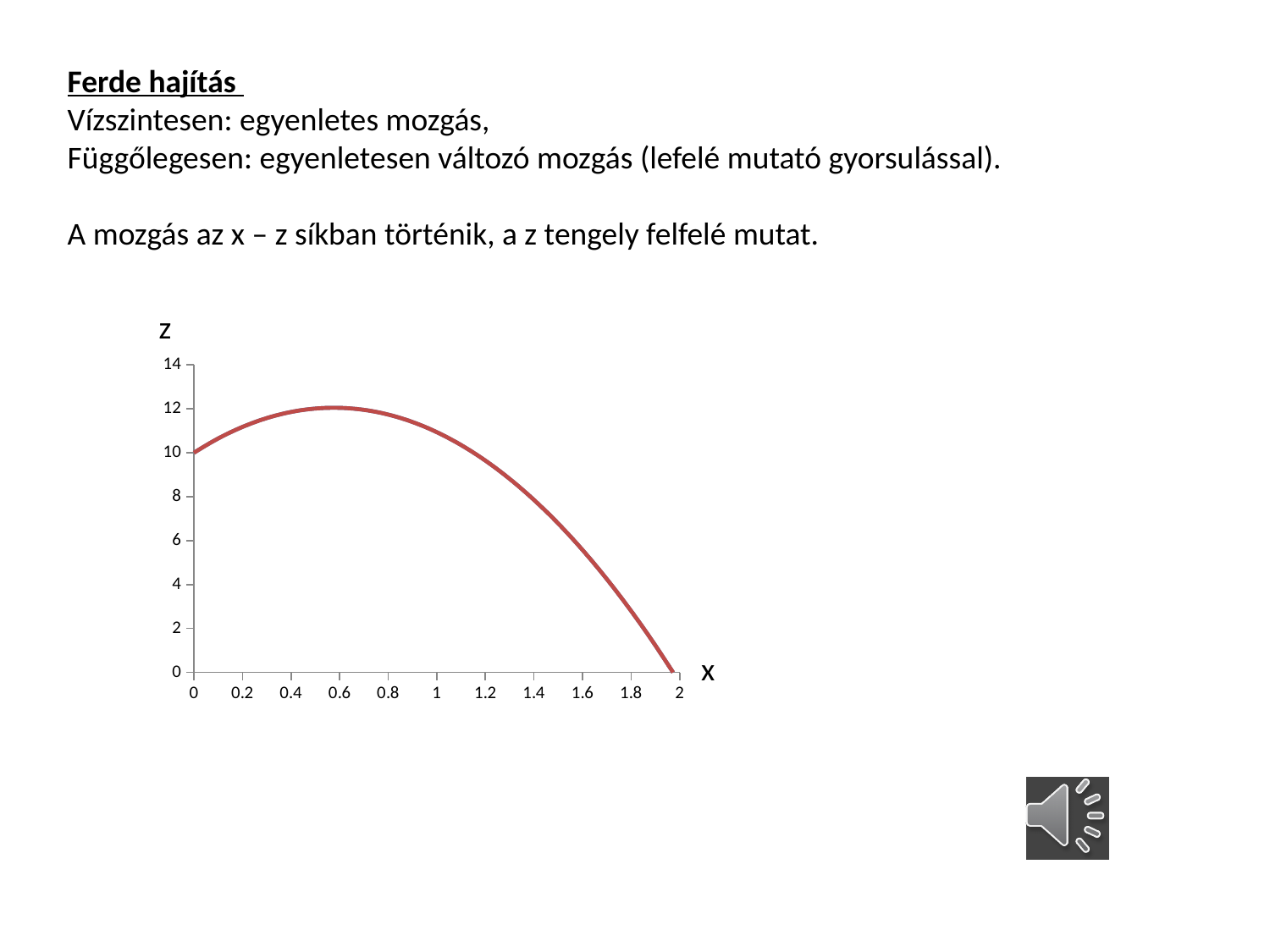
Which is larger, z at x = 0.4 or z at x = 1.4? z at x = 0.4 What kind of chart is shown on the slide? line chart How does z change as x increases from 0 to 2? rises then falls Is the value of z at x = 1.6 greater or less than 8? less Is the value of z at x = 1.8 greater or less than 4? less What is the label of the vertical axis? z What is the value of z at x = 0? 10 Does z rise or fall as x increases from 1 to 1.8? fall Is the value of z at x = 1 greater or less than 6? greater What is the label of the horizontal axis? x